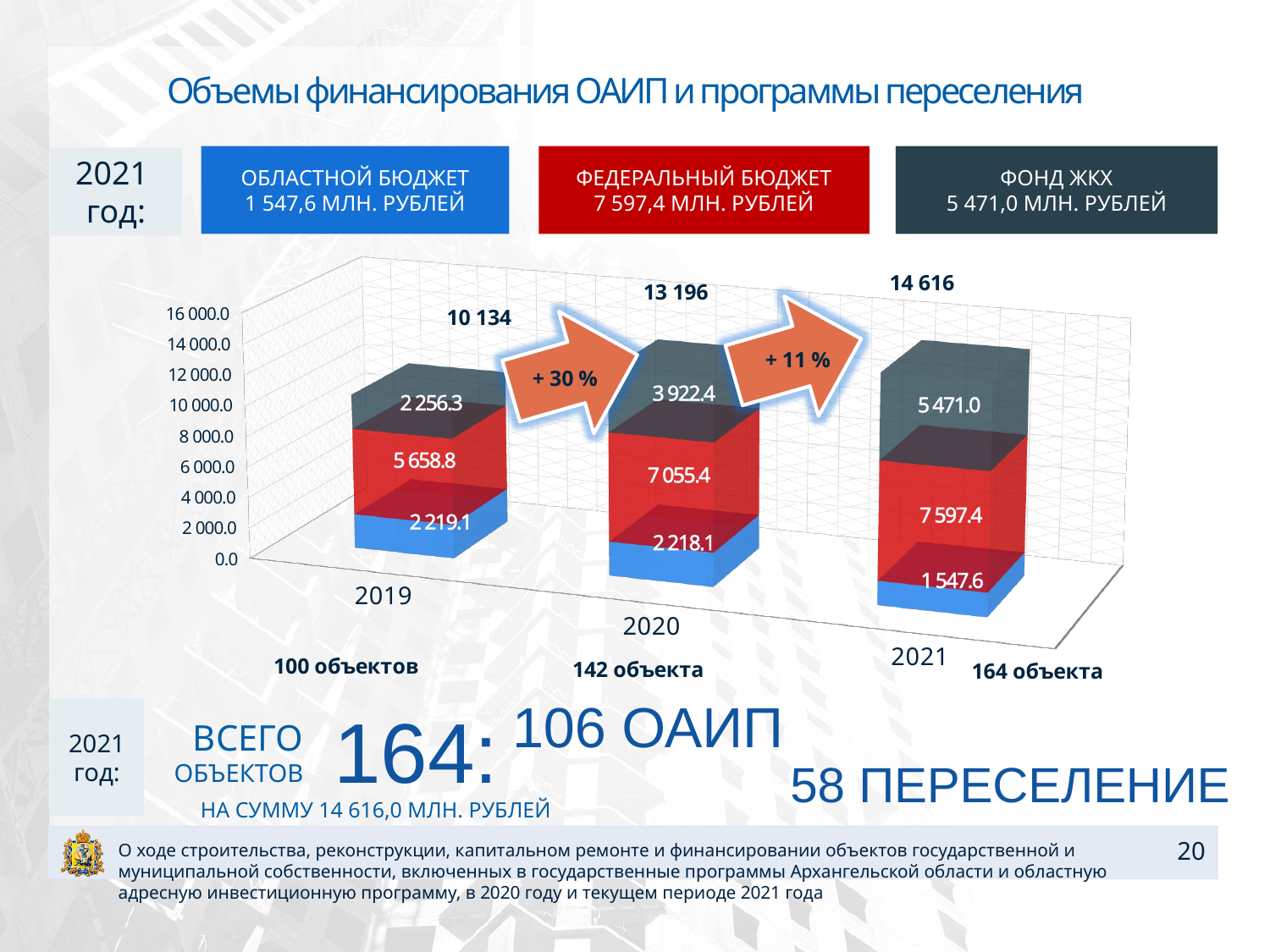
How many years (categories) are plotted on the x axis of the chart? 3 What kind of chart is shown on the slide? stacked bar chart What is the total of the stacked bar for 2020? 13 196 What is the value of the blue segment for 2021? 1 547.6 What is the title of the slide containing the chart? Объемы финансирования ОАИП и программы переселения Which year has the lowest total stacked bar? 2019 What is the difference between the dark (top) segment values for 2021 and 2020? 1 548.6 Do the total values of the stacked bars rise or fall from 2019 to 2021? rise Which year has the highest total stacked bar? 2021 Which is larger: the red segment for 2019 or the red segment for 2021? 2021 What is the value of the dark (top) segment for 2019? 2 256.3 What is the value of the red segment for 2020? 7 055.4